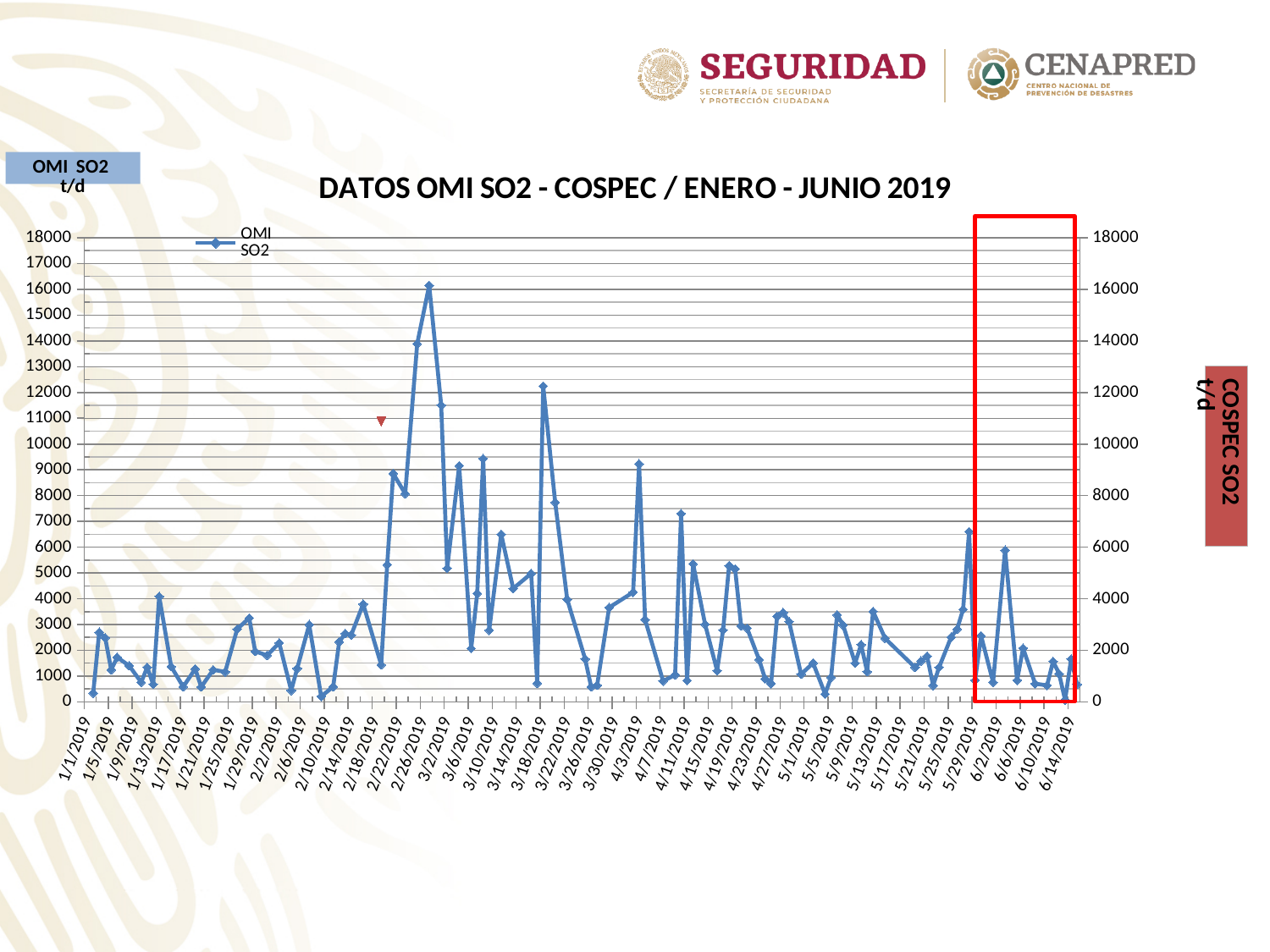
What is the title of the chart? DATOS OMI SO2 - COSPEC / ENERO - JUNIO 2019 What kind of chart is shown on the slide? line chart Which date has the larger OMI SO2 value, 4/3/2019 or 4/11/2019? 4/3/2019 What series name does the chart legend show? OMI SO2 Is the OMI SO2 value for 4/3/2019 greater or less than 8000? greater Is the OMI SO2 value for 6/6/2019 greater or less than 7000? less How many series does the legend list? 1 Is the OMI SO2 value for 3/18/2019 greater or less than 11000? greater